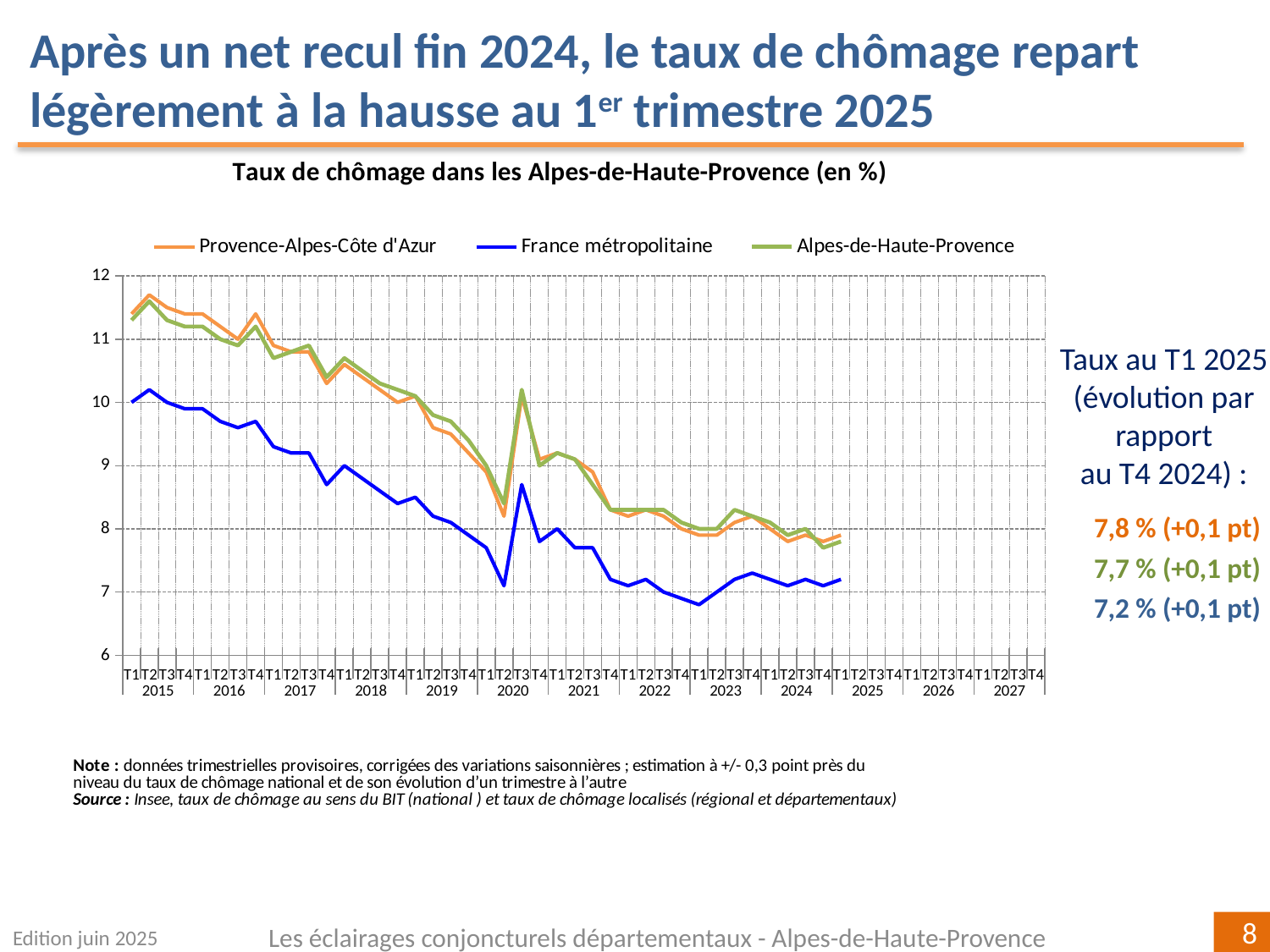
How many series does the chart legend list? 3 According to the annotation on the slide, what is the unemployment rate for Provence-Alpes-Côte d'Azur at T1 2025? 7,8 % Is the value for France métropolitaine at T1 2020 greater or less than 8? less Which series has the lowest value at T1 2025? France métropolitaine At T1 2025, which is larger: the rate for Provence-Alpes-Côte d'Azur or for France métropolitaine? Provence-Alpes-Côte d'Azur Is the value for Provence-Alpes-Côte d'Azur at T1 2015 greater or less than 11? greater What is the difference between the T1 2025 rates for Provence-Alpes-Côte d'Azur (7,8 %) and France métropolitaine (7,2 %)? 0,6 pt What kind of chart is shown on the slide? Line chart What colour is the line for France métropolitaine? Blue Overall, do the unemployment rates rise or fall between 2015 and 2025? Fall According to the annotation on the slide, what is the unemployment rate for France métropolitaine at T1 2025? 7,2 % What is the title of the chart? Taux de chômage dans les Alpes-de-Haute-Provence (en %)